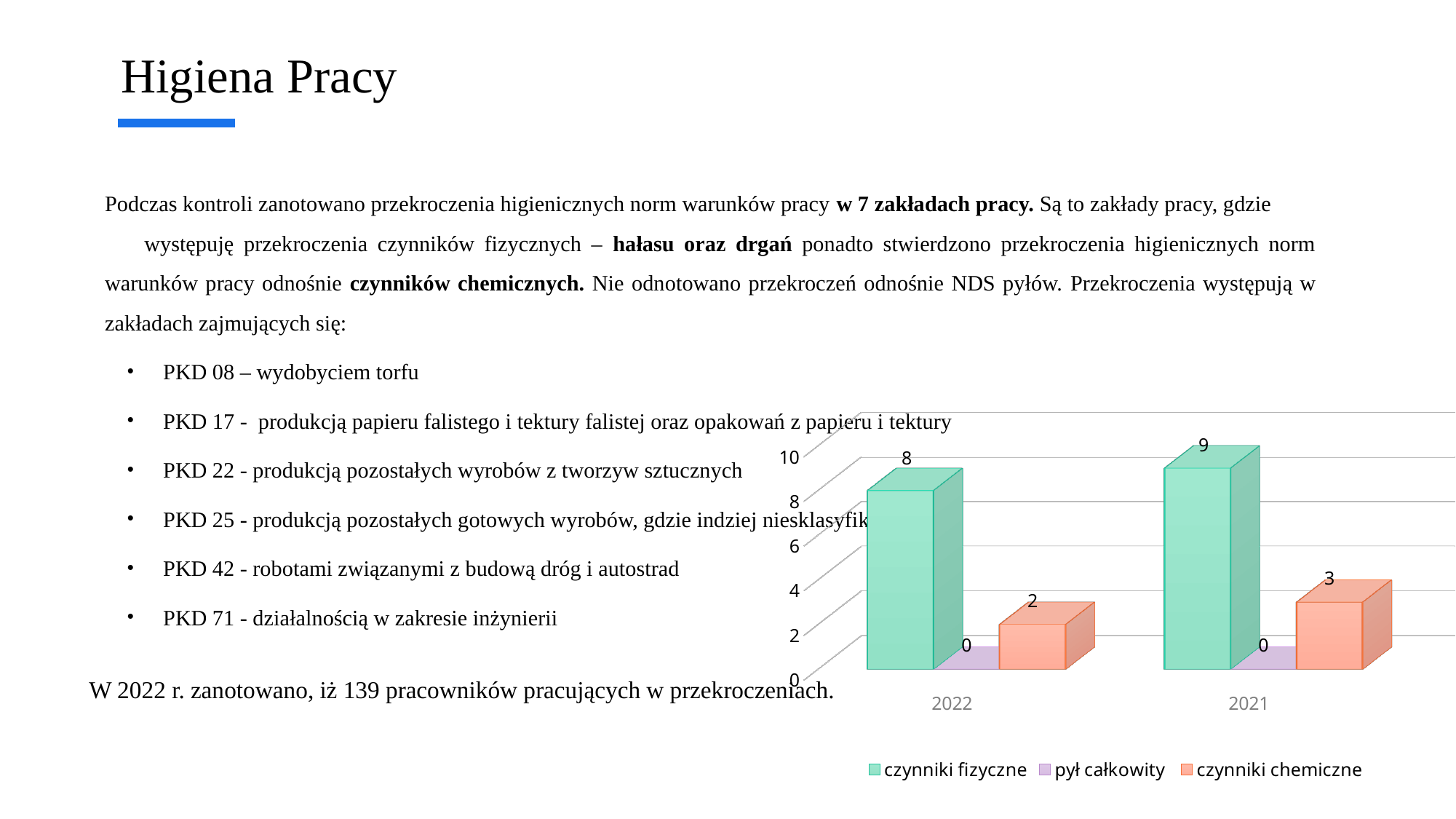
What is the value for czynniki fizyczne in 2022? 8 Which is larger: czynniki chemiczne in 2021 or czynniki chemiczne in 2022? czynniki chemiczne in 2021 Which series has the highest value in 2021? czynniki fizyczne What is the value for pył całkowity in 2022? 0 What is the value for czynniki chemiczne in 2022? 2 How many series does the chart legend list? 3 What is the value for czynniki fizyczne in 2021? 9 Which series has the lowest value in 2022? pył całkowity What kind of chart is shown on the slide? bar chart What is the difference between czynniki fizyczne in 2021 and in 2022? 1 What is the value for czynniki chemiczne in 2021? 3 How many categories are shown on the x axis of the chart? 2